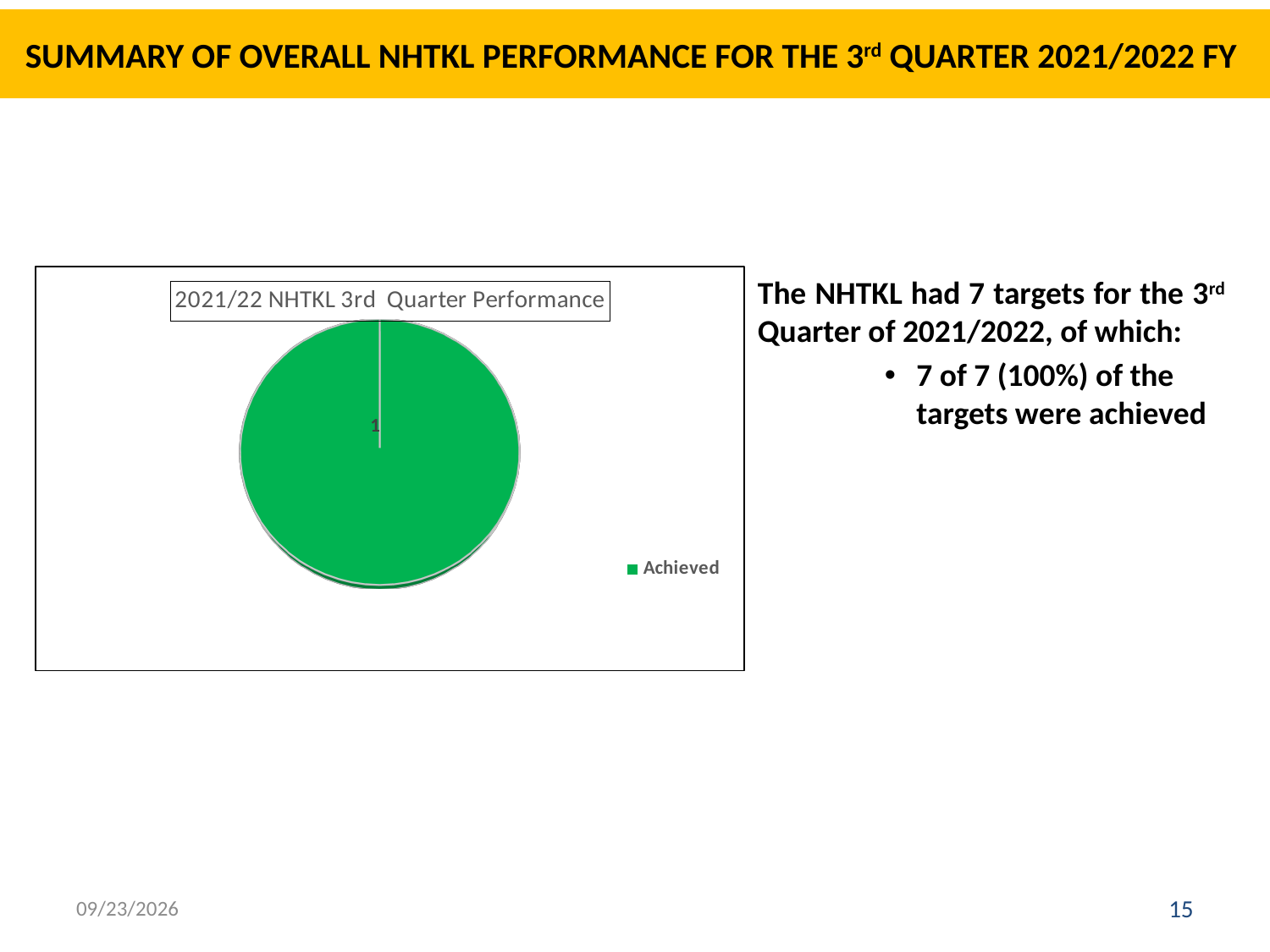
What category is listed in the chart legend? Achieved How many slices does the pie chart have? 1 What kind of chart is shown on the slide? pie chart What is the data label shown on the Achieved slice? 1 Which category makes up the largest slice of the pie? Achieved What is the title of the chart? 2021/22 NHTKL 3rd Quarter Performance What share of the pie does the Achieved slice represent? 100% How many entries does the chart legend list? 1